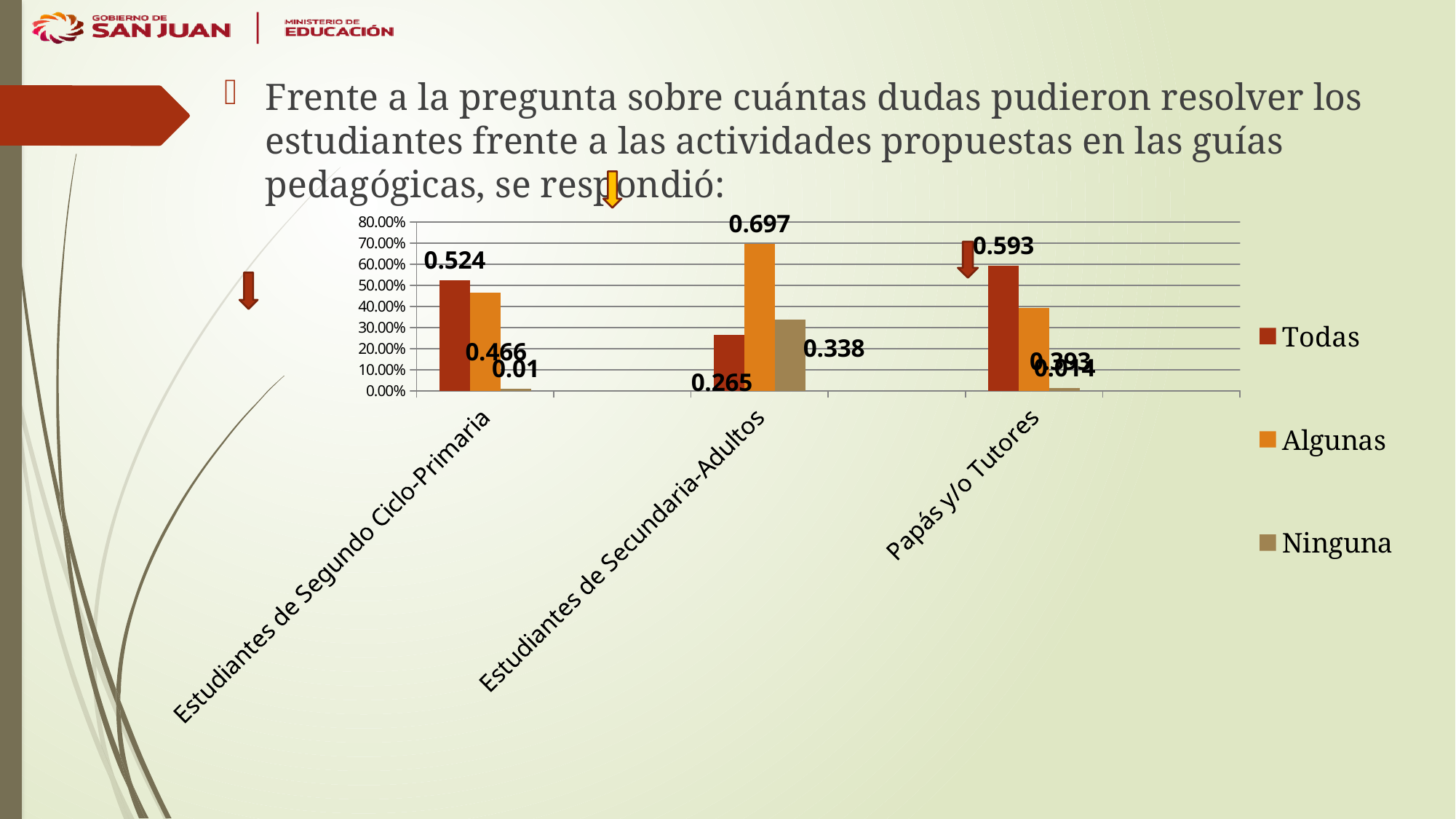
What is the value of Ninguna for Estudiantes de Segundo Ciclo-Primaria? 0.01 What type of chart is shown on the slide? bar chart What is the value of Todas for Papás y/o Tutores? 0.593 What is the value of Ninguna for Estudiantes de Secundaria-Adultos? 0.338 Which category has the lowest value for Todas? Estudiantes de Secundaria-Adultos How many series does the legend list? 3 What is the difference between the Todas values for Papás y/o Tutores and Estudiantes de Segundo Ciclo-Primaria? 0.069 What is the value of Todas for Estudiantes de Segundo Ciclo-Primaria? 0.524 What is the value of Algunas for Estudiantes de Secundaria-Adultos? 0.697 Is the value of Algunas for Papás y/o Tutores greater or less than 30.00%? greater How many categories are shown on the x axis? 3 Which category has the highest value for Algunas? Estudiantes de Secundaria-Adultos